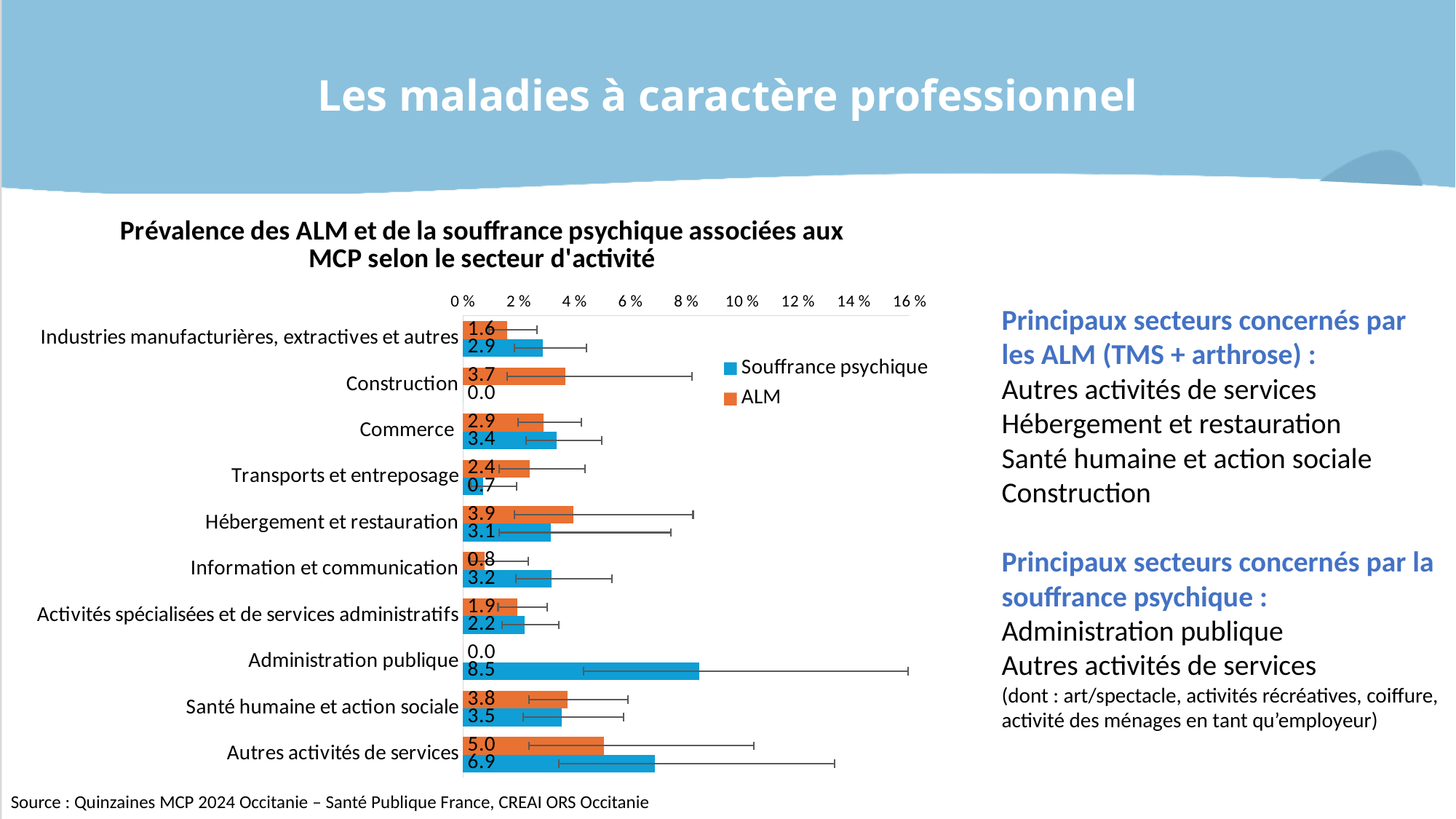
What is the Souffrance psychique value for Administration publique? 8.5 What is the Souffrance psychique value for Information et communication? 3.2 Which sector has the highest ALM value? Autres activités de services How many series does the legend list? 2 What is the ALM value for Hébergement et restauration? 3.9 Which sector has the highest Souffrance psychique value? Administration publique Is the Souffrance psychique value for Administration publique greater or less than 8 %? greater What is the ALM value for Autres activités de services? 5.0 What is the difference between the Souffrance psychique and ALM values for Autres activités de services? 1.9 What kind of chart is shown on the slide? Bar chart How many sectors are shown on the chart? 10 For Construction, which is larger: the ALM value or the Souffrance psychique value? ALM